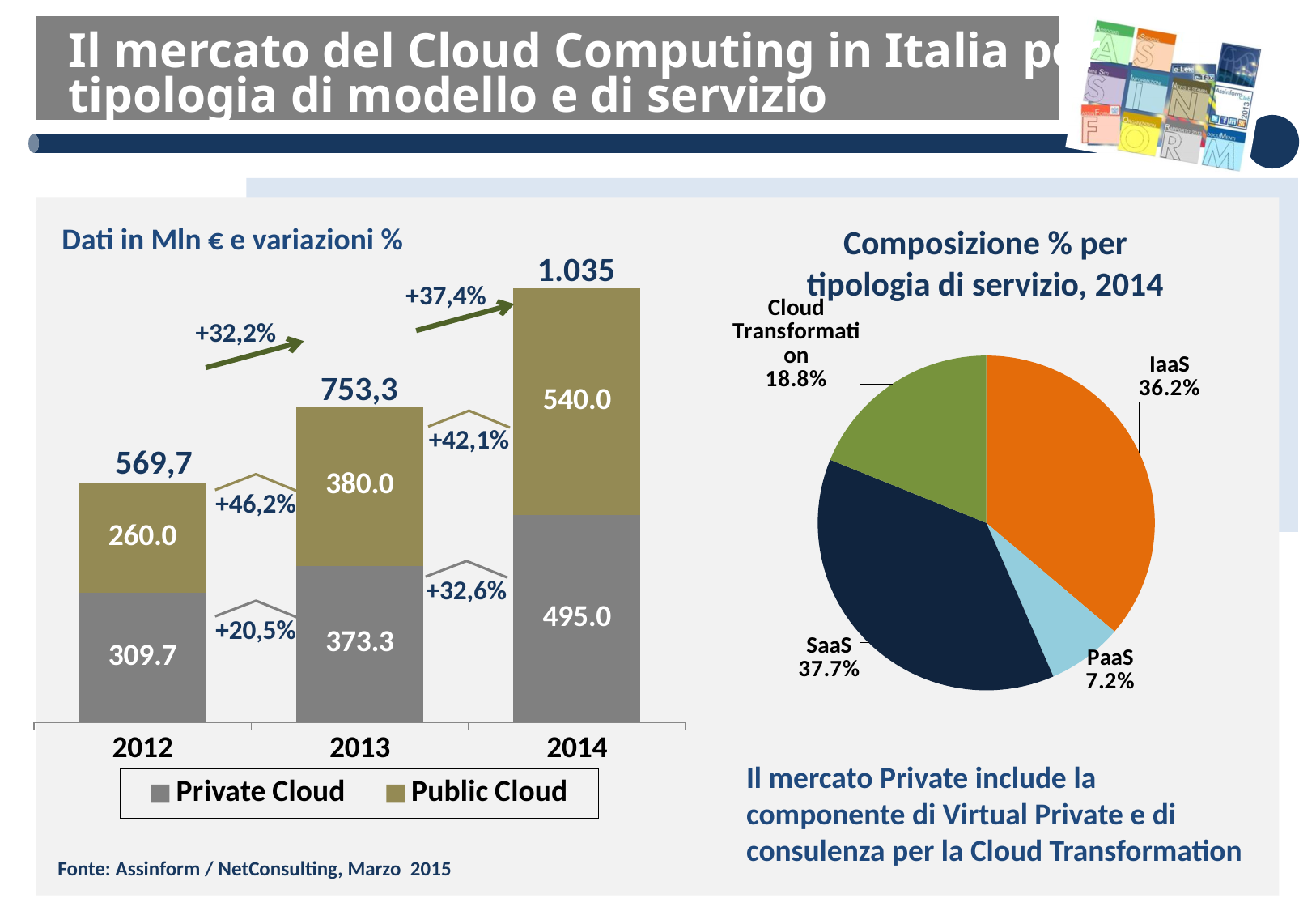
In the stacked bar chart on the left, which is larger in 2013: Private Cloud or Public Cloud? Public Cloud In the pie chart 'Composizione % per tipologia di servizio, 2014', what share does Cloud Transformation have? 18.8% In the stacked bar chart on the left, do the total values rise or fall from 2012 to 2014? Rise In the stacked bar chart on the left, how many years are shown on the x axis? 3 In the stacked bar chart on the left, what is the Private Cloud value for 2012? 309.7 In the stacked bar chart on the left, how many series does the legend list? 2 In the pie chart 'Composizione % per tipologia di servizio, 2014', which slice is the smallest? PaaS What kind of chart is the chart on the left of the slide? Stacked bar chart In the stacked bar chart on the left, what is the difference between the Public Cloud values for 2014 and 2013? 160.0 In the pie chart 'Composizione % per tipologia di servizio, 2014', which slice is the largest? SaaS In the stacked bar chart on the left, what is the total of the 2013 bar? 753,3 In the stacked bar chart on the left, what is the Public Cloud value for 2014? 540.0